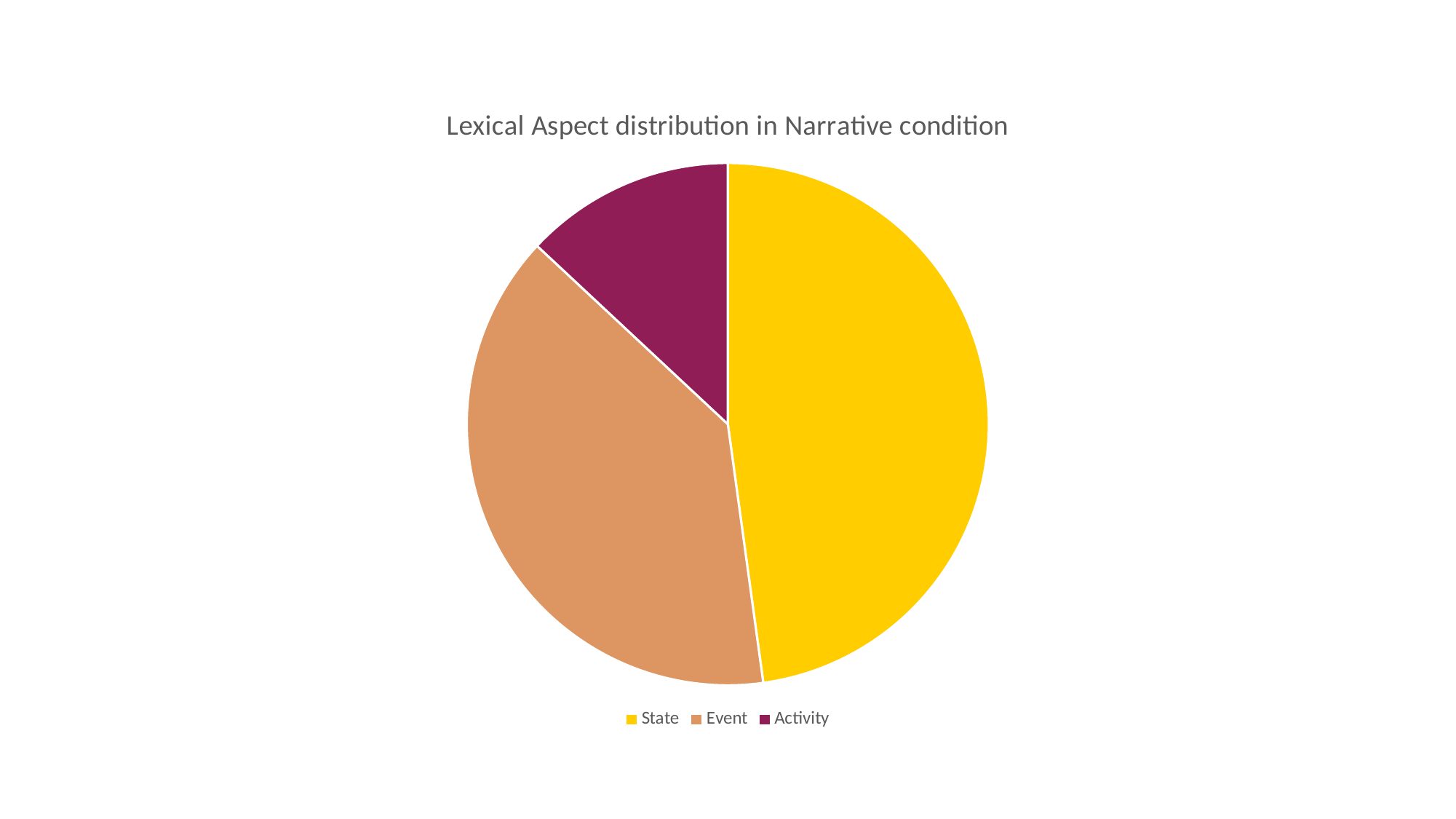
Which slice is larger, Event or Activity? Event Which category is shown in yellow? State Which category has the smallest slice of the pie? Activity What is the title of the chart? Lexical Aspect distribution in Narrative condition Which category has the largest slice of the pie? State How many categories does the legend list? 3 Which colour represents the Activity category? purple Which slice is larger, State or Event? State What kind of chart is shown on the slide? pie chart